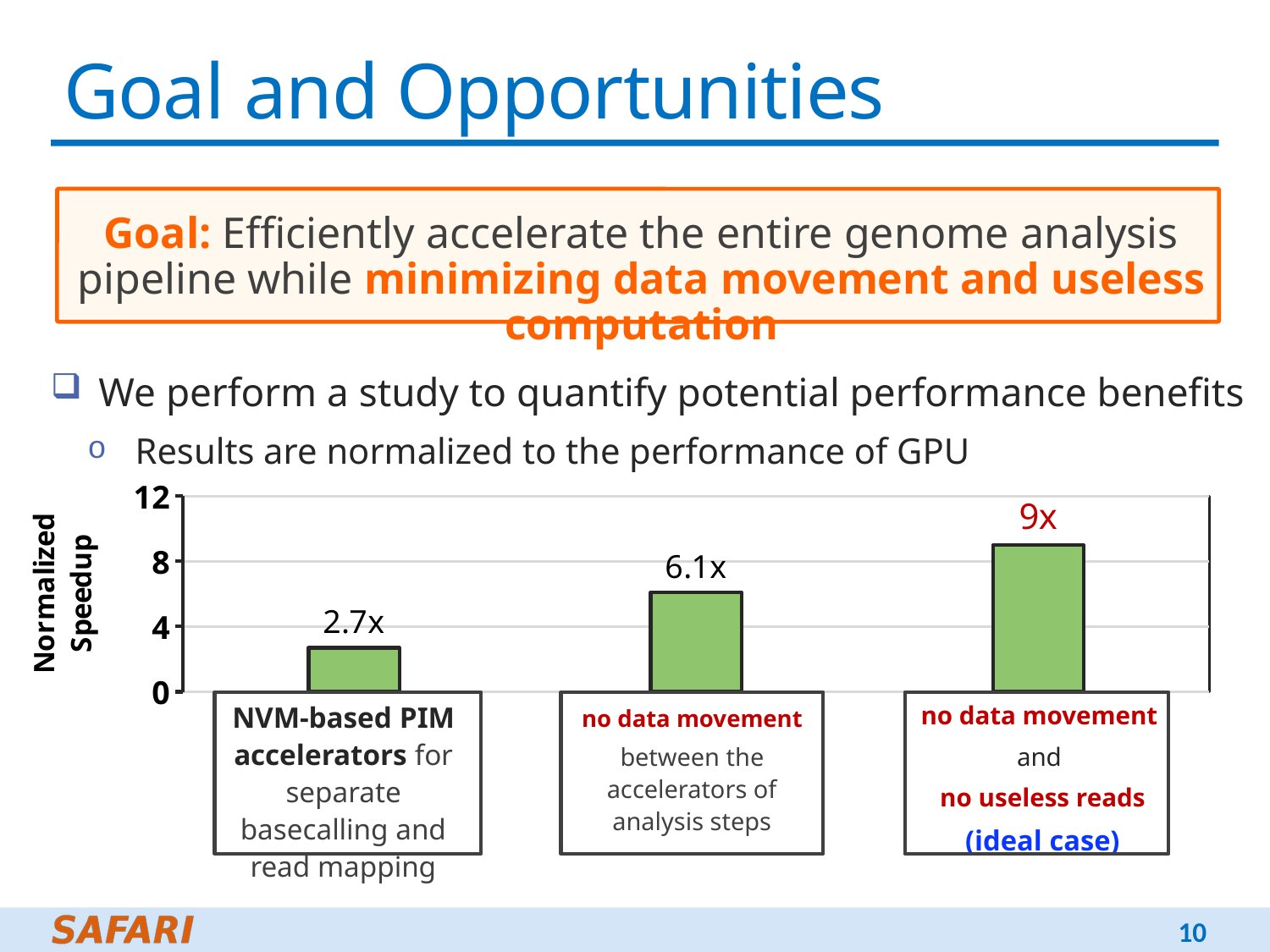
What is the normalized speedup for the ideal case with no data movement and no useless reads? 9x Which has a larger normalized speedup: the no data movement configuration or the ideal case? the ideal case Which configuration has the lowest normalized speedup? NVM-based PIM accelerators for separate basecalling and read mapping What is the label of the y axis? Normalized Speedup How many bars are shown in the chart? 3 What is the normalized speedup for NVM-based PIM accelerators for separate basecalling and read mapping? 2.7x Is the normalized speedup for the no data movement configuration greater or less than 8? less What is the normalized speedup when there is no data movement between the accelerators of analysis steps? 6.1x What is the difference in normalized speedup between the ideal case and the NVM-based PIM accelerators configuration? 6.3x Which configuration has the highest normalized speedup? no data movement and no useless reads (ideal case) What type of chart is shown on the slide? bar chart What is the difference in normalized speedup between the no data movement configuration and the NVM-based PIM accelerators configuration? 3.4x